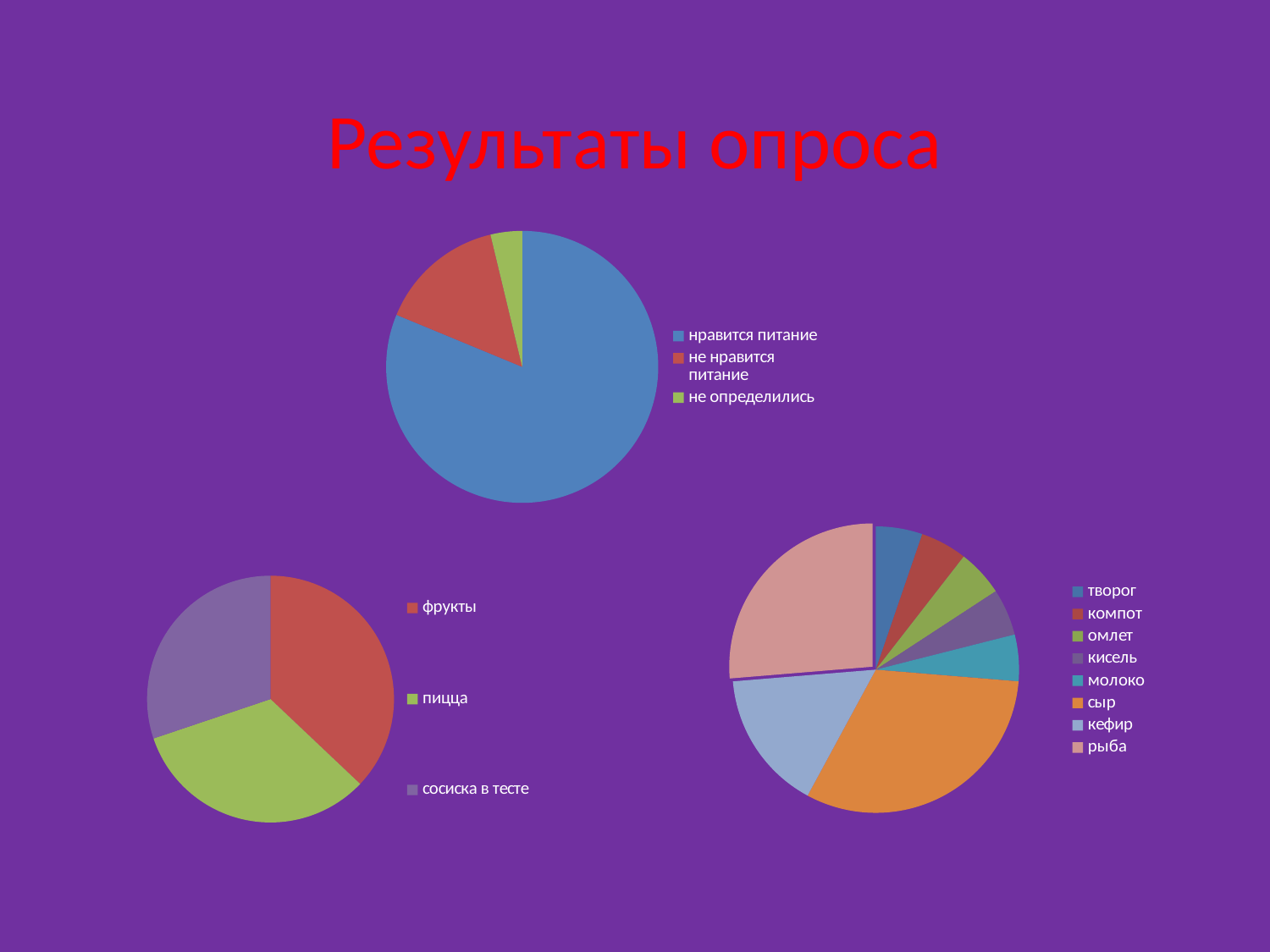
In the bottom-right pie chart, which category has the largest slice? сыр In the bottom-right pie chart, which slice is larger: 'рыба' or 'молоко'? рыба In the top pie chart, which category has the largest slice? нравится питание In the top pie chart, which category has the smallest slice? не определились What kind of chart is the bottom-left chart on the slide? pie chart How many categories does the legend of the bottom-left pie chart list? 3 In the bottom-right pie chart, which slice is larger: 'кефир' or 'творог'? кефир In the top pie chart, which slice is larger: 'не нравится питание' or 'не определились'? не нравится питание What is the title of the slide containing the charts? Результаты опроса How many slices does the top pie chart have? 3 How many slices does the bottom-right pie chart have? 8 What kind of chart is the top chart on the slide? pie chart